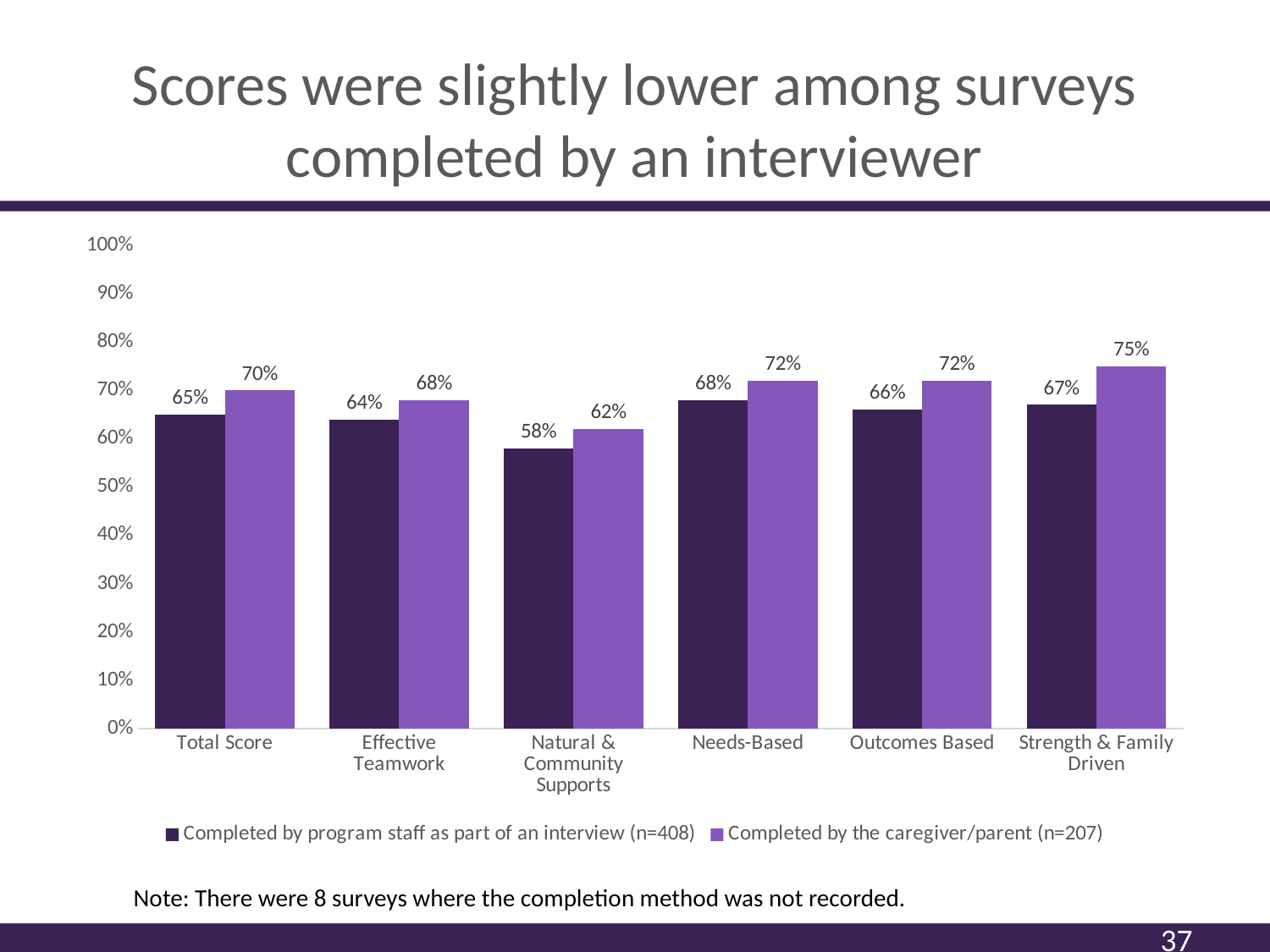
What is the Total Score for surveys completed by the caregiver/parent? 70% Which category has the lowest value for surveys completed by program staff as part of an interview? Natural & Community Supports Which category has the highest value for surveys completed by the caregiver/parent? Strength & Family Driven What is the difference between the caregiver/parent and program staff values for Strength & Family Driven? 8% What is the difference between the caregiver/parent and program staff values for Total Score? 5% What is the value for Natural & Community Supports for surveys completed by program staff as part of an interview? 58% What is the sample size (n) for surveys completed by program staff as part of an interview, according to the legend? 408 What kind of chart is shown on the slide? Bar chart How many series does the legend list? 2 What is the value for Strength & Family Driven for surveys completed by the caregiver/parent? 75% How many categories are shown on the x axis? 6 For Needs-Based, which is larger: the value for surveys completed by program staff or by the caregiver/parent? Completed by the caregiver/parent